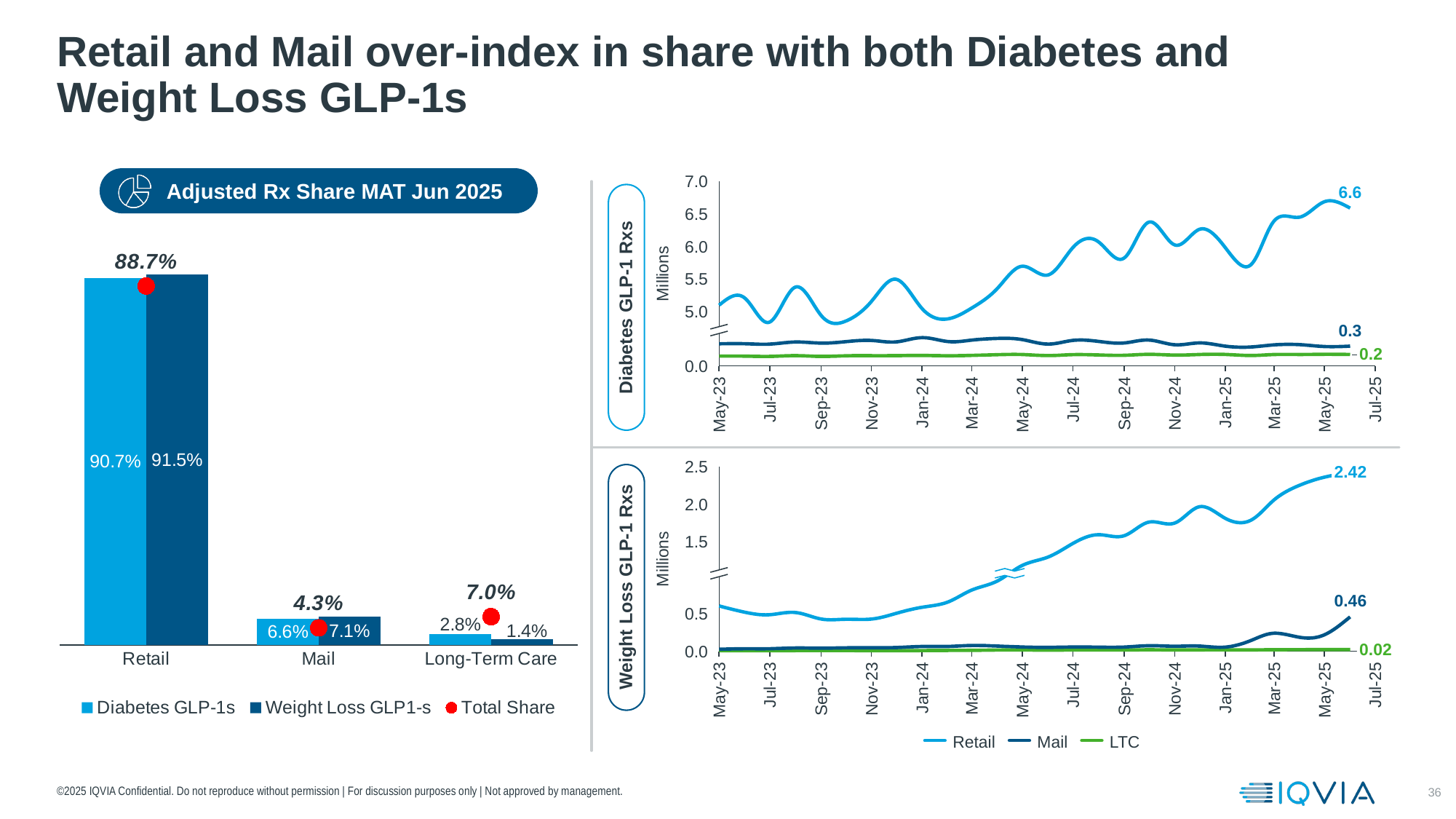
In the Adjusted Rx Share MAT Jun 2025 chart, which channel has the highest Diabetes GLP-1s share? Retail In the Weight Loss GLP-1 Rxs line chart, does the Retail line generally rise or fall from May-23 to May-25? rise In the Adjusted Rx Share MAT Jun 2025 chart, what is the Diabetes GLP-1s share for Retail? 90.7% In the Diabetes GLP-1 Rxs line chart, what is the final labelled value for Retail? 6.6 How many channel categories are shown on the x axis of the Adjusted Rx Share MAT Jun 2025 chart? 3 In the Weight Loss GLP-1 Rxs line chart, what is the final labelled value for Mail? 0.46 In the Adjusted Rx Share MAT Jun 2025 chart, for Long-Term Care, which is larger: the Diabetes GLP-1s share or the Weight Loss GLP1-s share? Diabetes GLP-1s How many series does the legend of the Weight Loss GLP-1 Rxs line chart list? 3 In the Adjusted Rx Share MAT Jun 2025 chart, what is the Weight Loss GLP1-s share for Mail? 7.1% In the Adjusted Rx Share MAT Jun 2025 chart, what is the difference between the Weight Loss GLP1-s share and the Diabetes GLP-1s share for Retail? 0.8% In the Adjusted Rx Share MAT Jun 2025 chart, what is the Total Share value for Long-Term Care? 7.0% In the Adjusted Rx Share MAT Jun 2025 chart, which channel has the lowest Weight Loss GLP1-s share? Long-Term Care